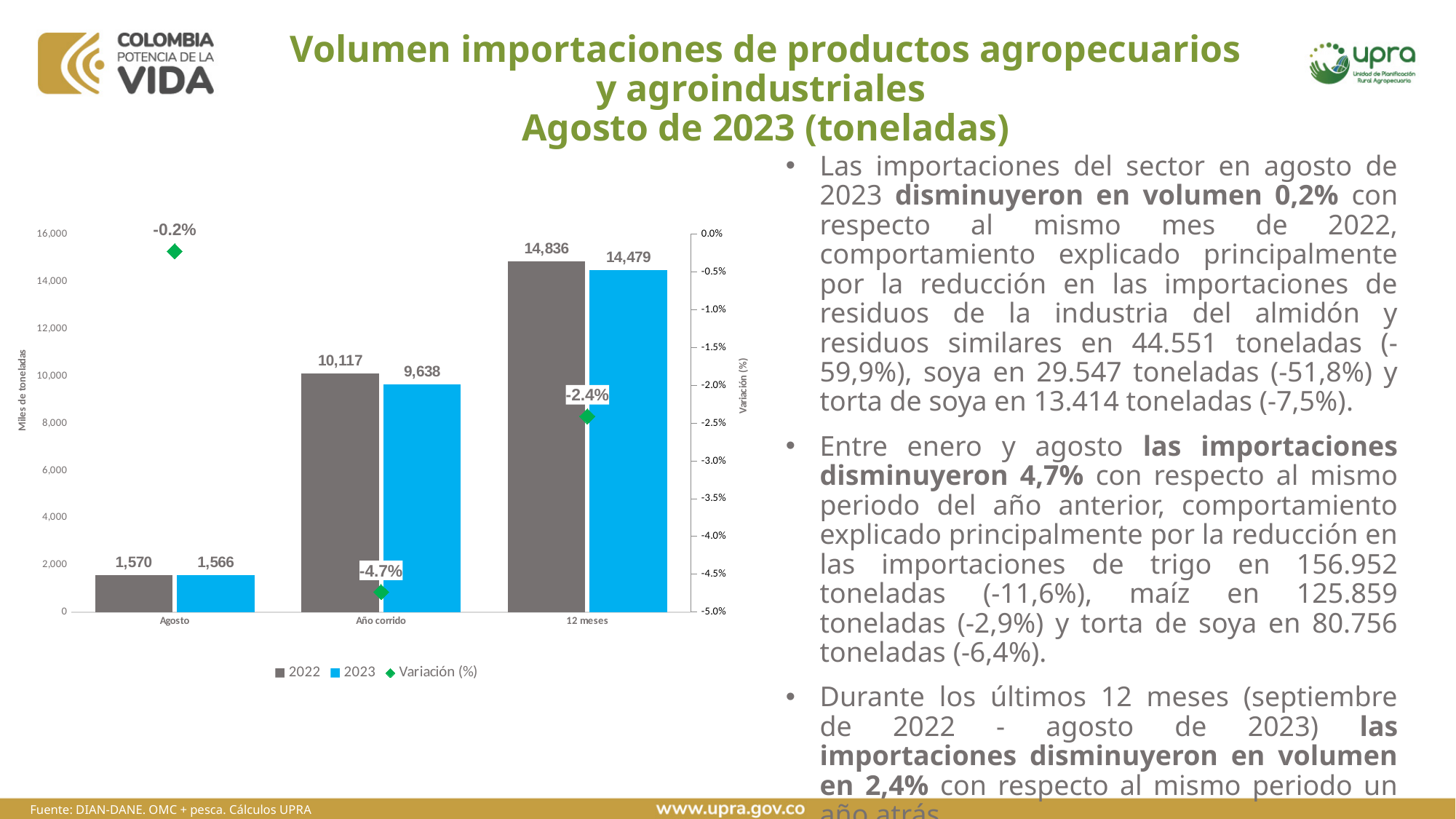
What is the difference between the 2022 and 2023 values for 12 meses? 357 How many categories are shown on the x axis? 3 What is the 2023 value for 12 meses? 14,479 What is the Variación (%) value for Agosto? -0.2% What is the 2022 value for Año corrido? 10,117 What is the label of the left vertical axis? Miles de toneladas How many series does the legend list? 3 What kind of chart is shown on the slide? Bar chart with a line/marker series Which category has the highest 2023 value? 12 meses What is the Variación (%) value for Año corrido? -4.7% Which category has the lowest 2022 value? Agosto Which is larger for Año corrido, the 2022 value or the 2023 value? 2022